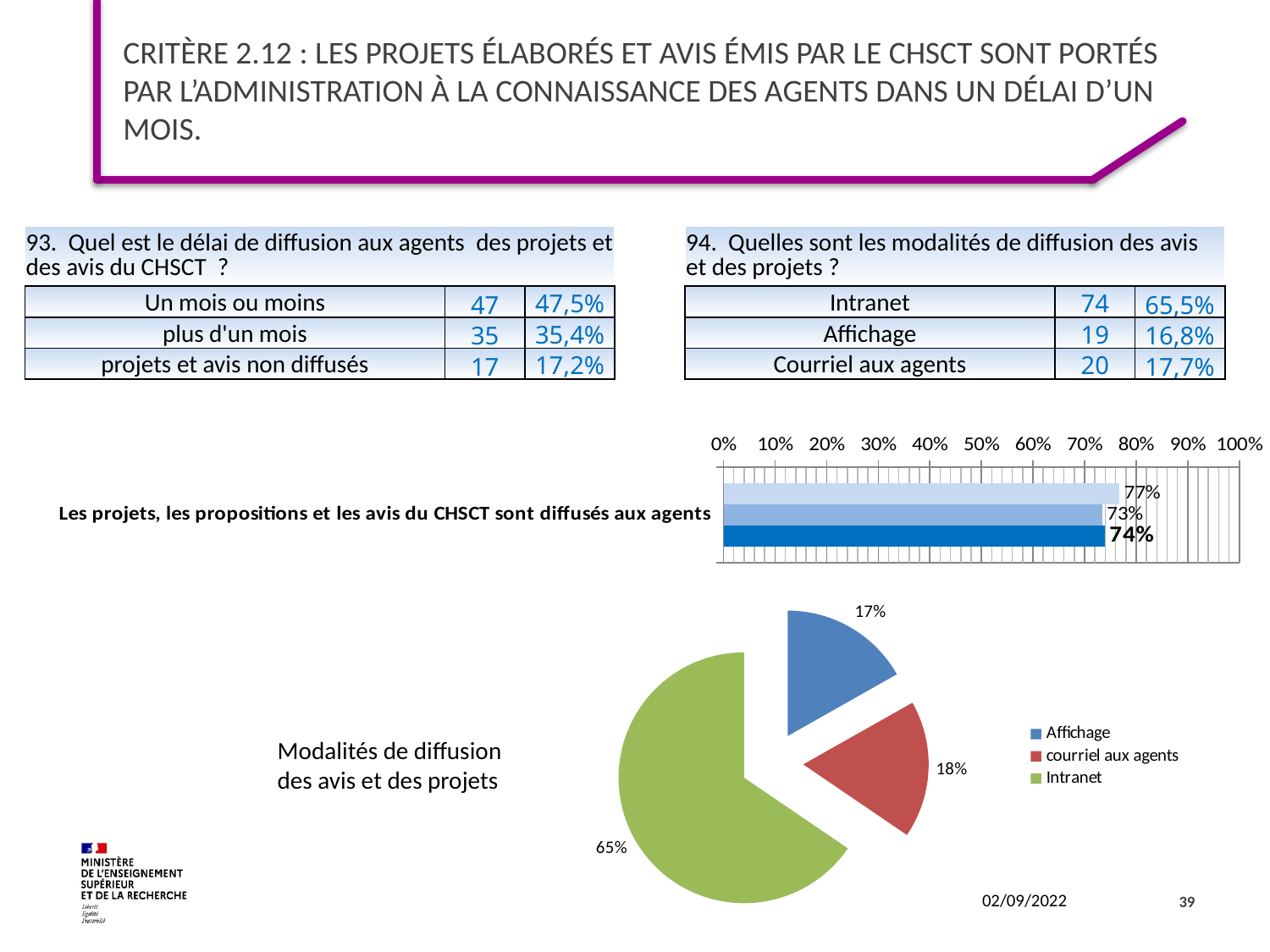
What kind of chart is the chart on the right side of the slide showing 77%, 73% and 74%? Bar chart In the pie chart 'Modalités de diffusion des avis et des projets', what share does 'courriel aux agents' have? 18% In the pie chart 'Modalités de diffusion des avis et des projets', how many entries does the legend list? 3 What kind of chart is the chart at the bottom of the slide titled 'Modalités de diffusion des avis et des projets'? Pie chart In the pie chart 'Modalités de diffusion des avis et des projets', what share does Intranet have? 65% In the bar chart for 'Les projets, les propositions et les avis du CHSCT sont diffusés aux agents', what is the value of the top (lightest blue) bar? 77% In the pie chart 'Modalités de diffusion des avis et des projets', what share does Affichage have? 17% In the bar chart for 'Les projets, les propositions et les avis du CHSCT sont diffusés aux agents', what is the difference in percentage points between the highest bar and the lowest bar? 4 percentage points In the bar chart for 'Les projets, les propositions et les avis du CHSCT sont diffusés aux agents', what is the value of the bottom (dark blue) bar? 74% In the pie chart 'Modalités de diffusion des avis et des projets', what is the difference in percentage points between Intranet and 'courriel aux agents'? 47 percentage points In the pie chart 'Modalités de diffusion des avis et des projets', which category has the smallest slice? Affichage In the pie chart 'Modalités de diffusion des avis et des projets', which category has the largest slice? Intranet